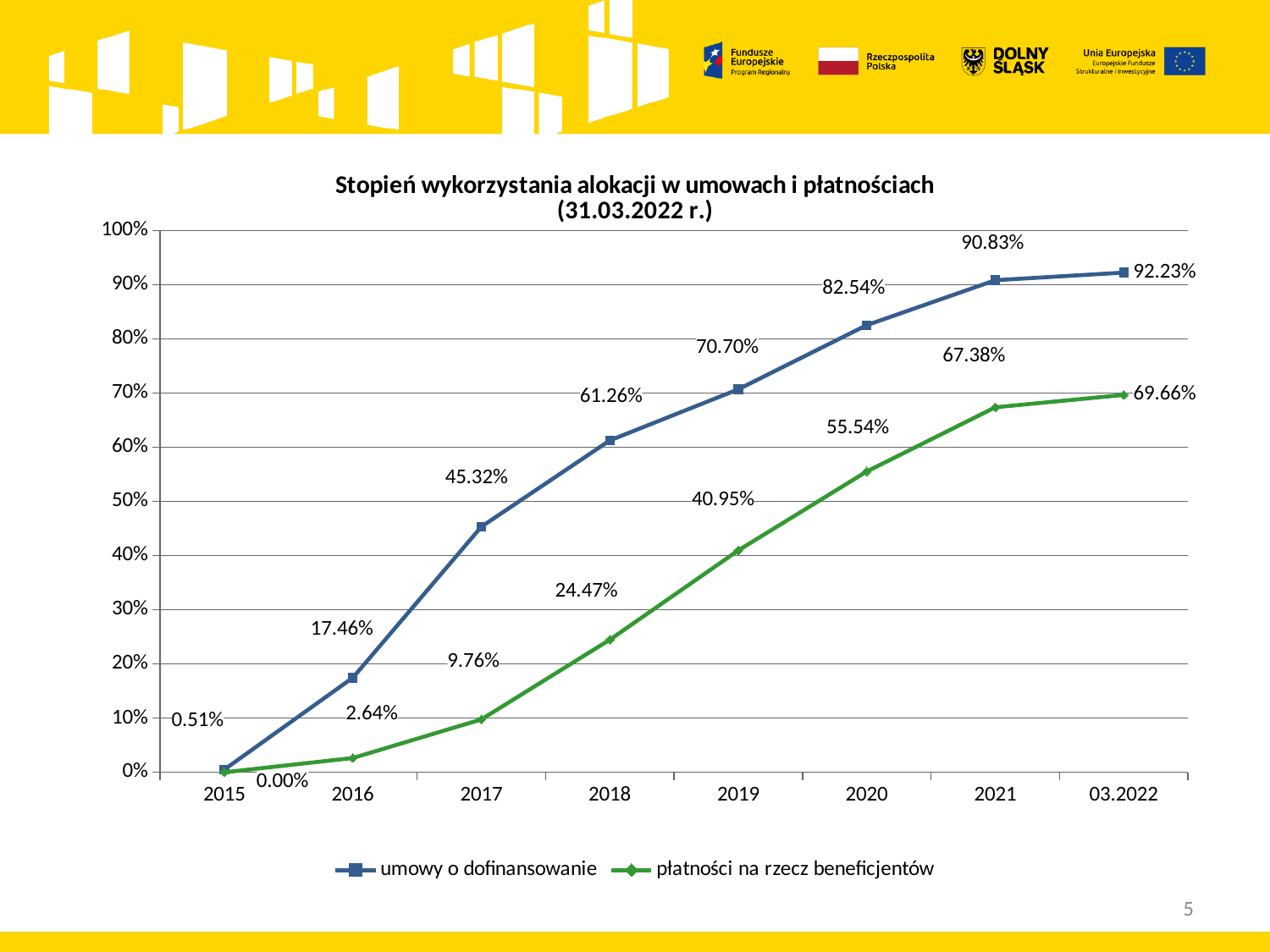
Which series has the larger value in 2018, "umowy o dofinansowanie" or "płatności na rzecz beneficjentów"? umowy o dofinansowanie In which year is the value for "płatności na rzecz beneficjentów" lowest? 2015 Do the values for "płatności na rzecz beneficjentów" rise or fall from 2015 to 03.2022? rise What is the value for "płatności na rzecz beneficjentów" in 2016? 2.64% How many series does the legend list? 2 What is the value for "płatności na rzecz beneficjentów" in 2019? 40.95% What is the difference between "umowy o dofinansowanie" and "płatności na rzecz beneficjentów" in 2020? 27.00% What is the value for "umowy o dofinansowanie" in 2017? 45.32% At which point on the x axis is the value for "umowy o dofinansowanie" highest? 03.2022 How many points on the x axis does the chart show? 8 What kind of chart is shown on the slide? line chart What is the value for "umowy o dofinansowanie" at 03.2022? 92.23%